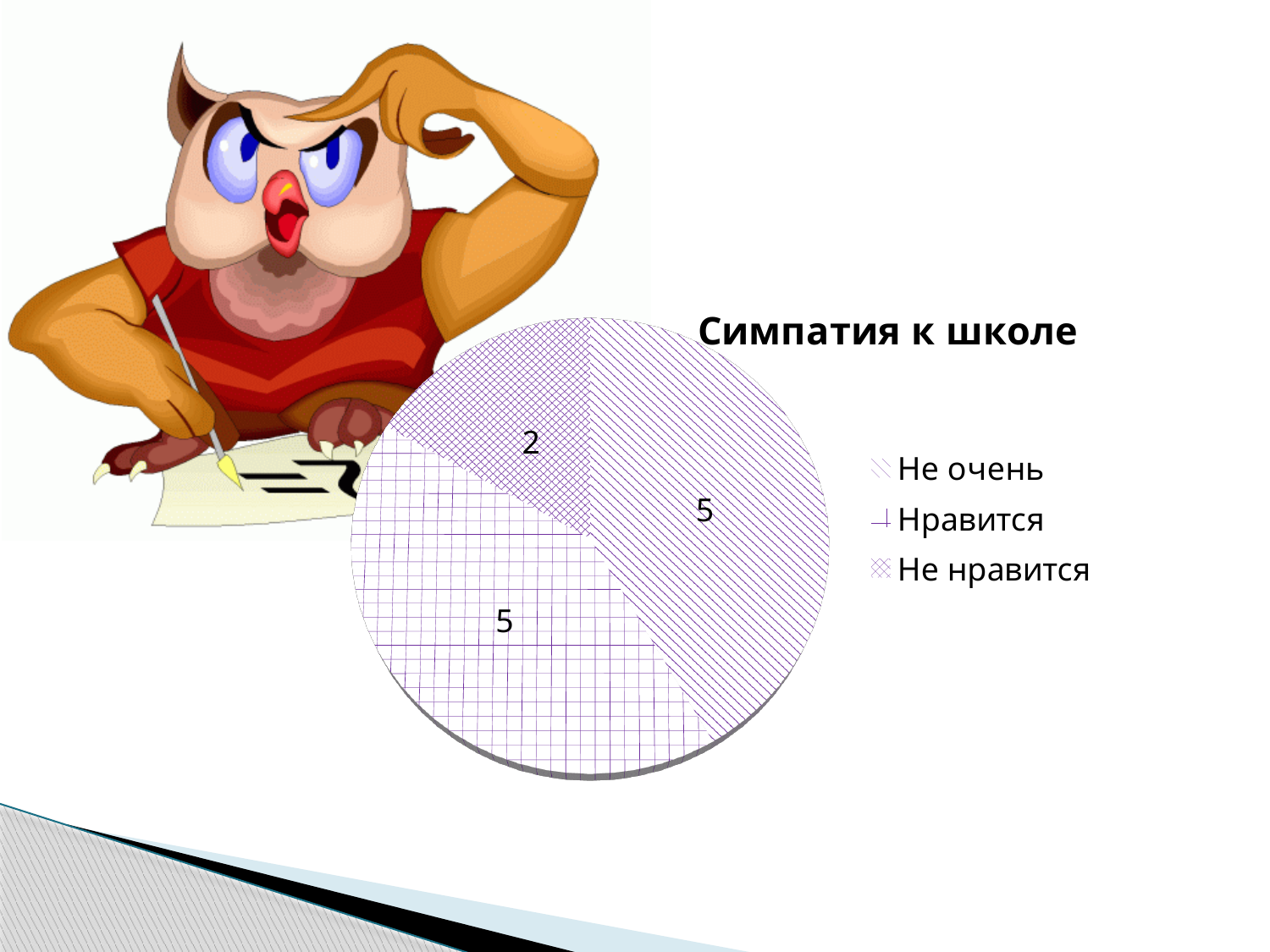
Which legend entry is listed first? Не очень What is the difference between the values for "Нравится" and "Не нравится"? 3 How many slices does the pie chart have? 3 What is the value for "Не нравится"? 2 What is the value for "Не очень"? 5 What is the total of all the slice values in the pie chart? 12 Which is larger, the value for "Не очень" or the value for "Не нравится"? Не очень What kind of chart is shown on the slide? pie chart Which category has the smallest slice? Не нравится How many entries does the legend list? 3 What is the title of the chart? Симпатия к школе What is the value for "Нравится"? 5